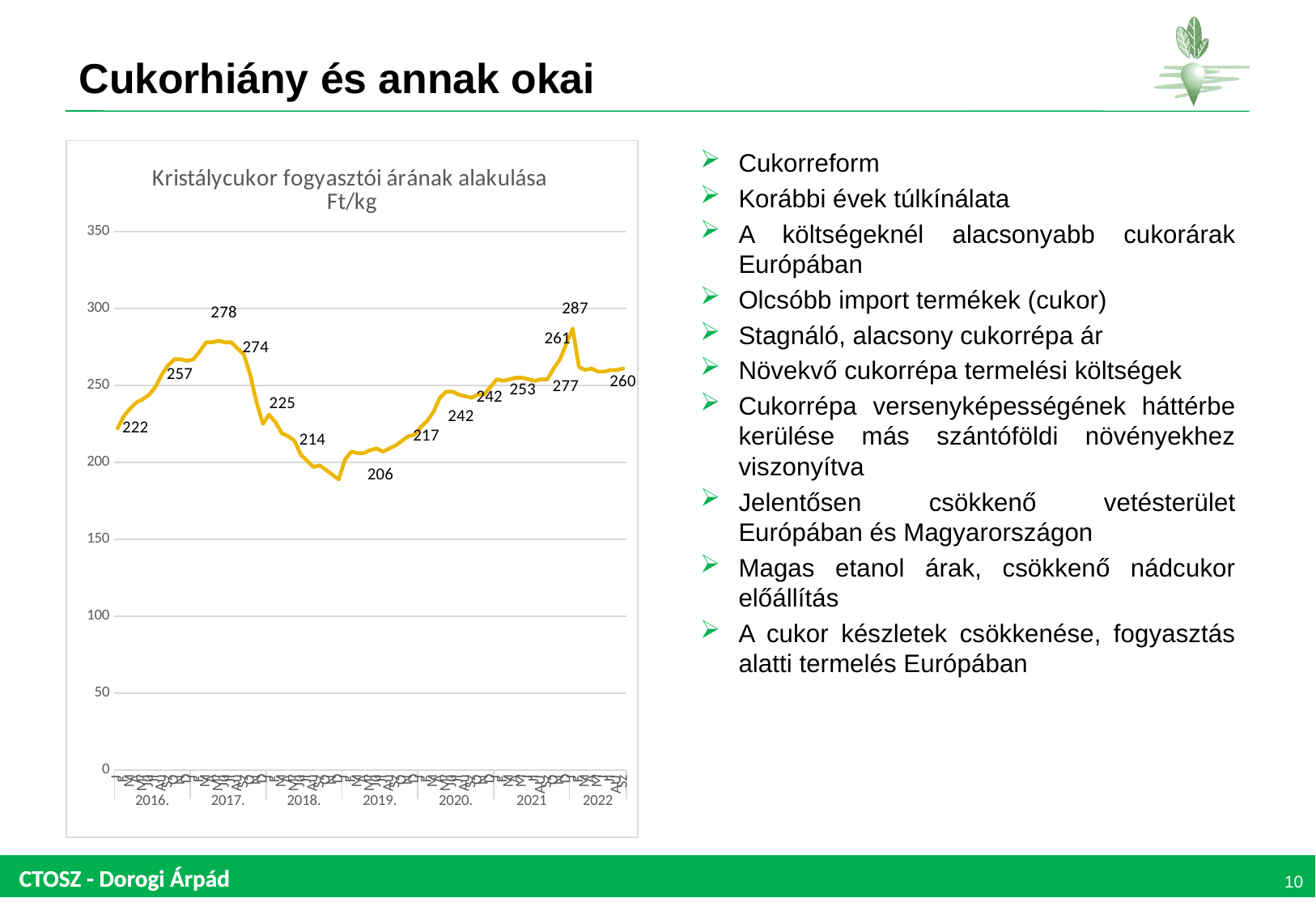
What is the highest data label shown on the line? 287 How many years are labelled on the x axis? 7 What is the title of the chart? Kristálycukor fogyasztói árának alakulása Ft/kg Does the line rise or fall from the start of 2016 to the start of 2017? rise What is the first data label shown at the start of the line in 2016? 222 What is the difference between the highest labelled value (287) and the lowest labelled value (206)? 81 What is the lowest data label shown on the line? 206 Which is larger, the labelled peak in 2017 (278) or the labelled peak in 2021 (287)? 287 What kind of chart is shown on the slide? line chart What is the last data label shown at the end of the line in 2022? 260 Does the line rise or fall during 2018? fall